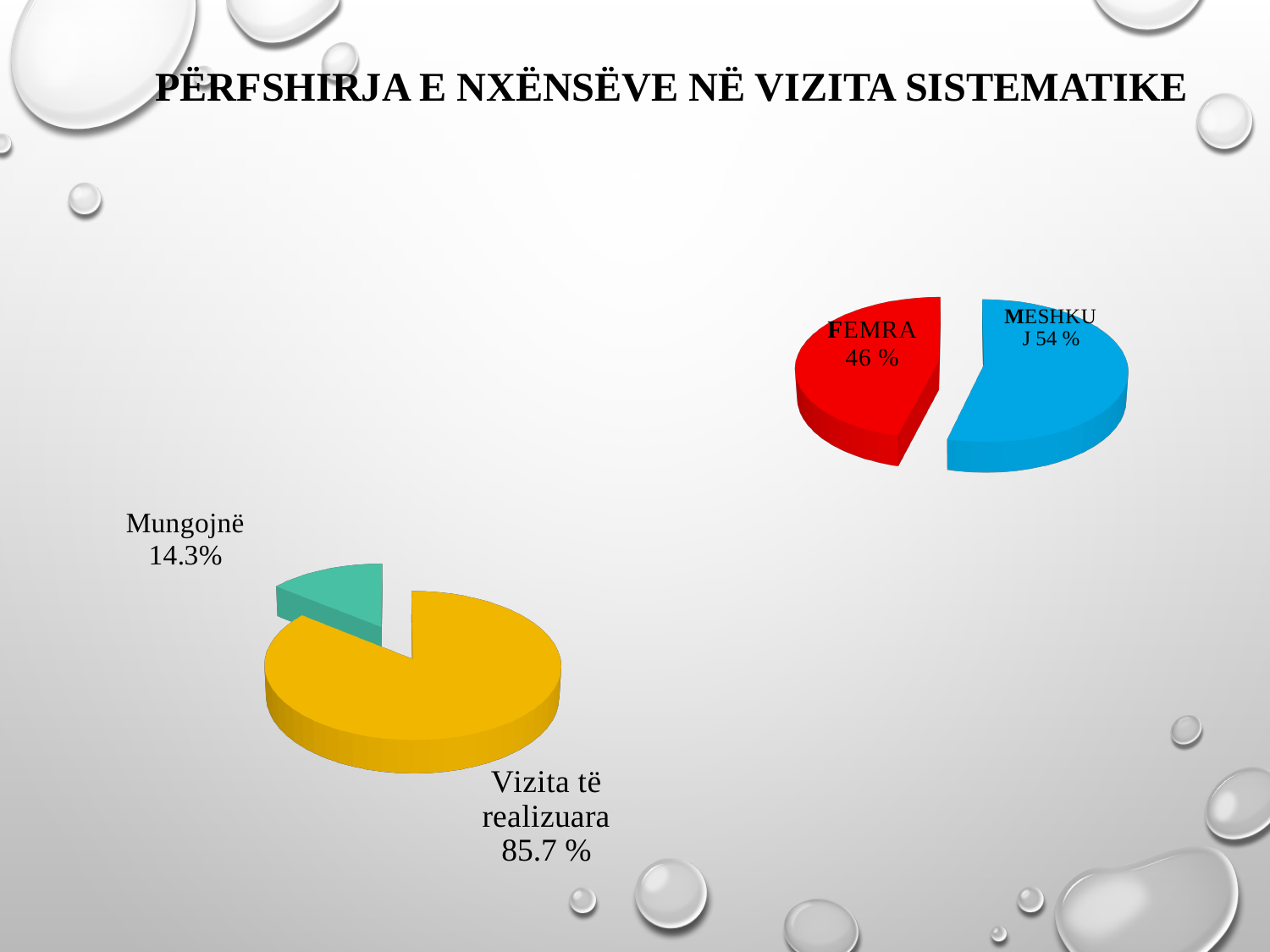
In the lower-left pie chart, what is the difference between the Vizita të realizuara and Mungojnë shares? 71.4 % In the lower-left pie chart, what colour is the Mungojnë slice? teal/green In the lower-left pie chart, what share is labelled for Mungojnë? 14.3% In the upper-right pie chart, what share is labelled for FEMRA? 46 % In the upper-right pie chart, what is the difference between the MESHKUJ and FEMRA shares? 8 % What kind of chart is the chart in the lower left of the slide? pie chart In the lower-left pie chart, what share is labelled for Vizita të realizuara? 85.7 % In the upper-right pie chart, which slice is larger, FEMRA or MESHKUJ? MESHKUJ What kind of chart is the chart in the upper right of the slide? pie chart How many slices does the upper-right pie chart have? 2 In the lower-left pie chart, which slice is the smallest? Mungojnë